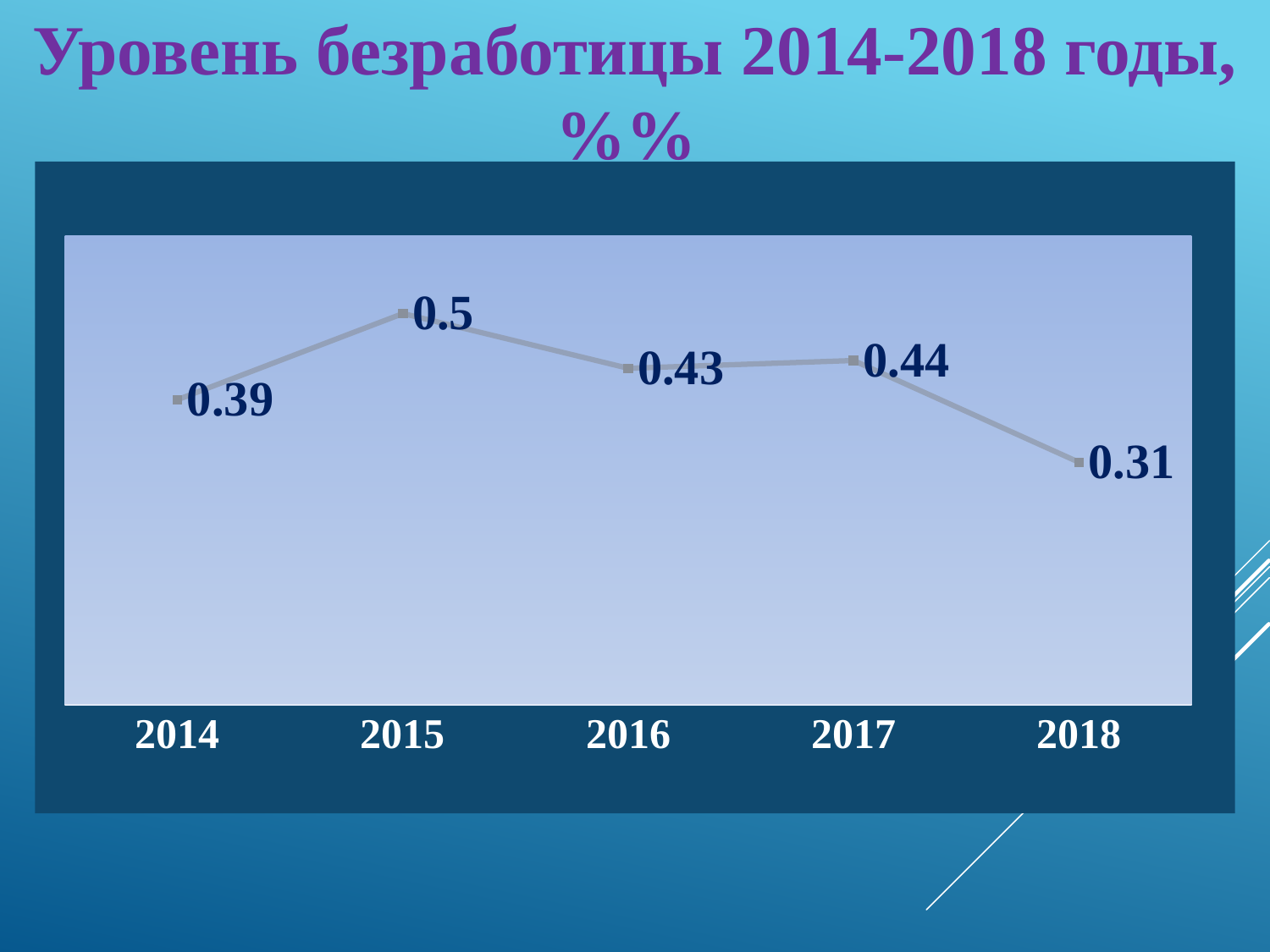
Does the value rise or fall from 2017 to 2018? fall What is the difference between the values for 2015 and 2018? 0.19 What is the value for 2014? 0.39 What is the value for 2017? 0.44 What is the value for 2015? 0.5 What is the value for 2016? 0.43 Which year has the highest value? 2015 Which year has the lowest value? 2018 How many years are plotted on the chart? 5 What is the value for 2018? 0.31 What kind of chart is shown on the slide? line chart Which is larger, the value for 2014 or the value for 2016? 2016